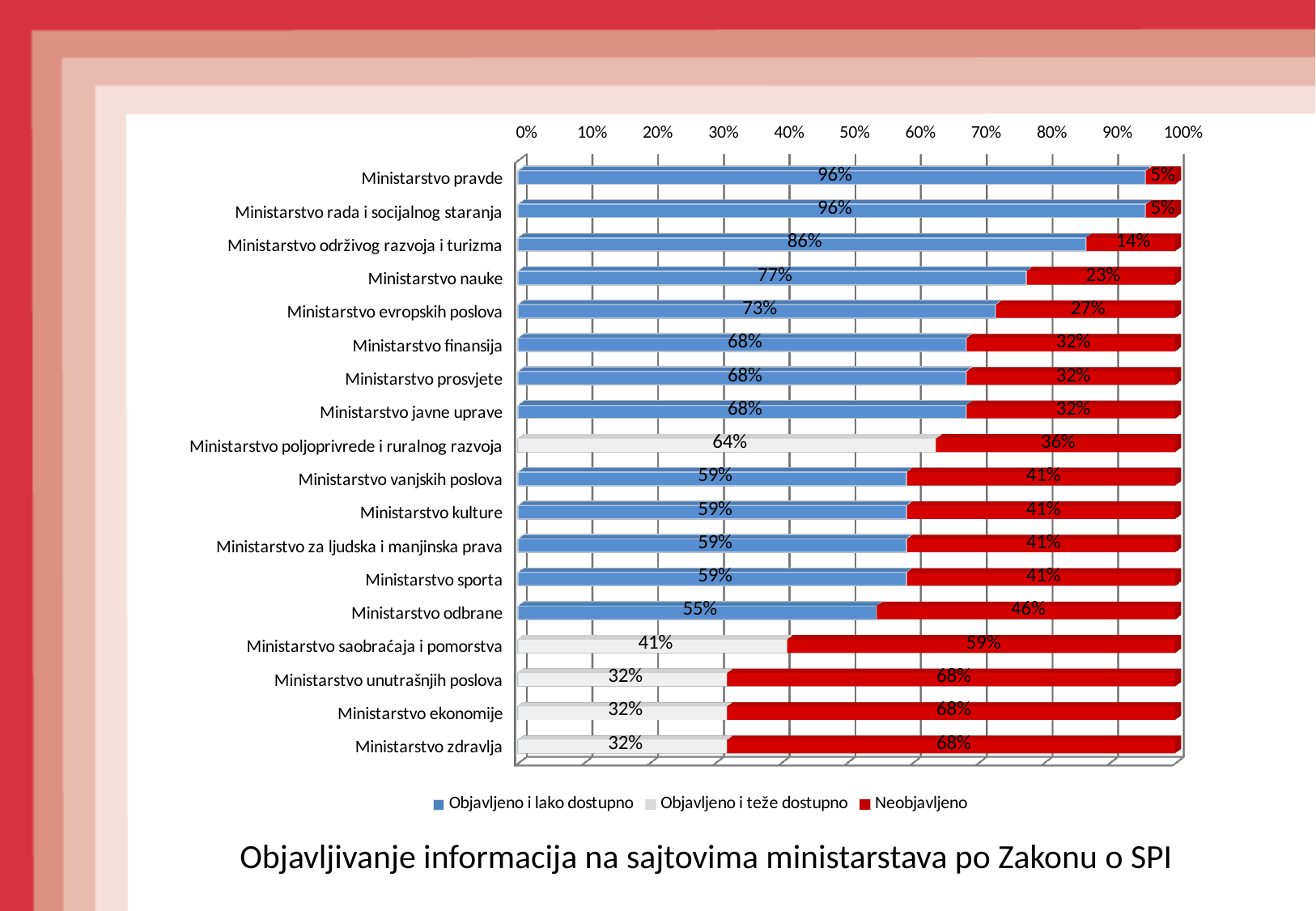
What is the "Neobjavljeno" value for Ministarstvo odbrane? 46% What is the value of "Objavljeno i lako dostupno" for Ministarstvo nauke? 77% Which has a larger "Neobjavljeno" value, Ministarstvo finansija or Ministarstvo vanjskih poslova? Ministarstvo vanjskih poslova How many series does the legend list? 3 What is the difference between the "Objavljeno i lako dostupno" values for Ministarstvo održivog razvoja i turizma and Ministarstvo nauke? 9 percentage points Is the "Objavljeno i lako dostupno" value for Ministarstvo evropskih poslova greater or less than 70%? greater How many ministries are shown in the chart? 18 What kind of chart is shown on the slide? Stacked bar chart What is the total of the stacked bar for Ministarstvo nauke? 100% Which ministry has the highest "Objavljeno i teže dostupno" value? Ministarstvo poljoprivrede i ruralnog razvoja What is the "Objavljeno i teže dostupno" value for Ministarstvo zdravlja? 32% What is the title of the chart? Objavljivanje informacija na sajtovima ministarstava po Zakonu o SPI